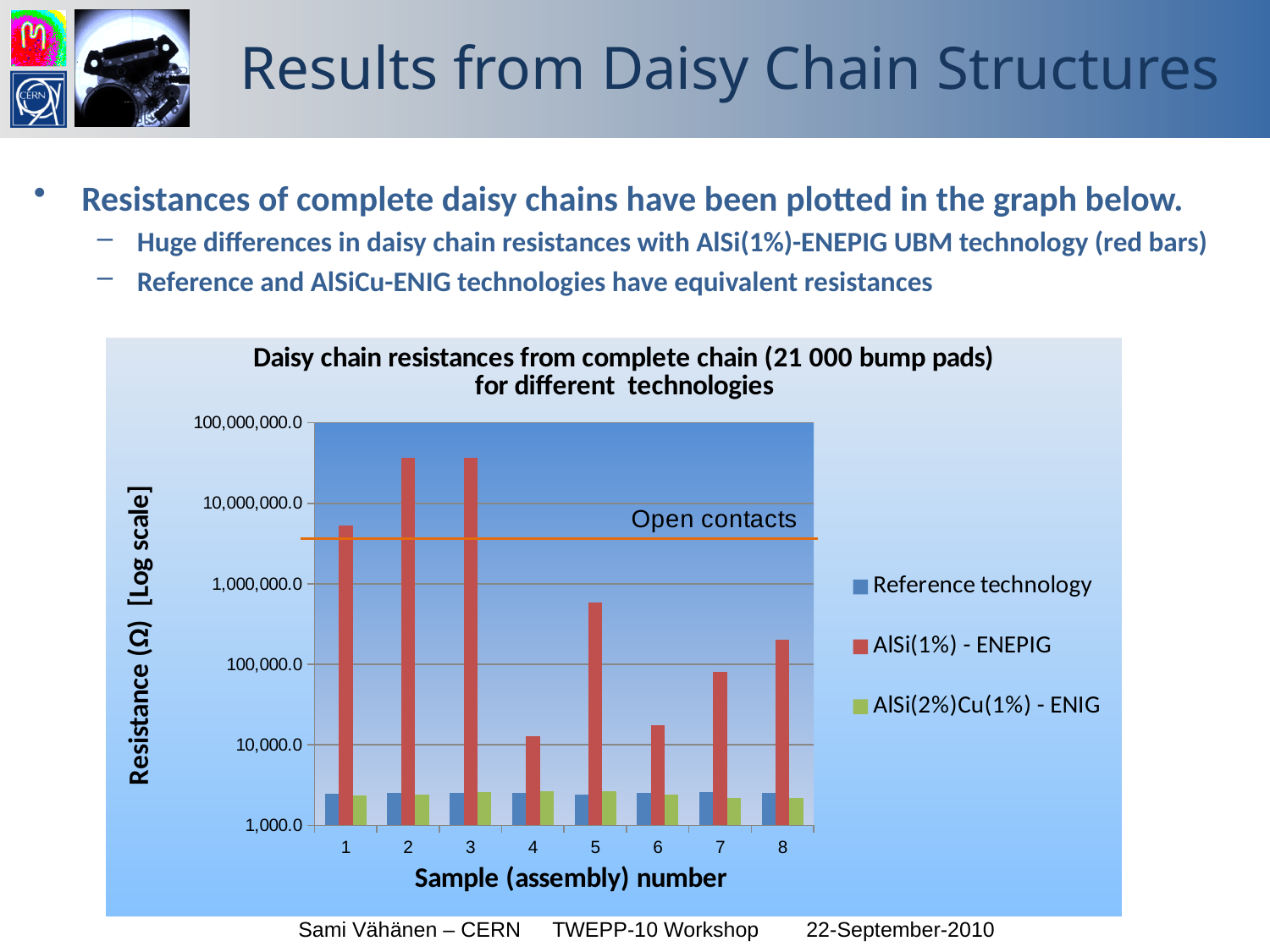
Is the AlSi(1%) - ENEPIG value for sample 1 greater or less than 10,000,000.0? less Is the Reference technology value for sample 3 greater or less than 10,000.0? less How many sample (assembly) numbers are shown on the x axis of the chart? 8 What kind of chart is shown on the slide? bar chart Is the AlSi(1%) - ENEPIG value for sample 2 greater or less than 10,000,000.0? greater Which is larger for sample 2, the AlSi(1%) - ENEPIG value or the Reference technology value? AlSi(1%) - ENEPIG Which series is shown in red in the chart's legend? AlSi(1%) - ENEPIG Which is larger, the AlSi(1%) - ENEPIG value for sample 5 or for sample 7? sample 5 What is the label of the chart's y axis? Resistance (Ω) [Log scale] How many series does the chart's legend list? 3